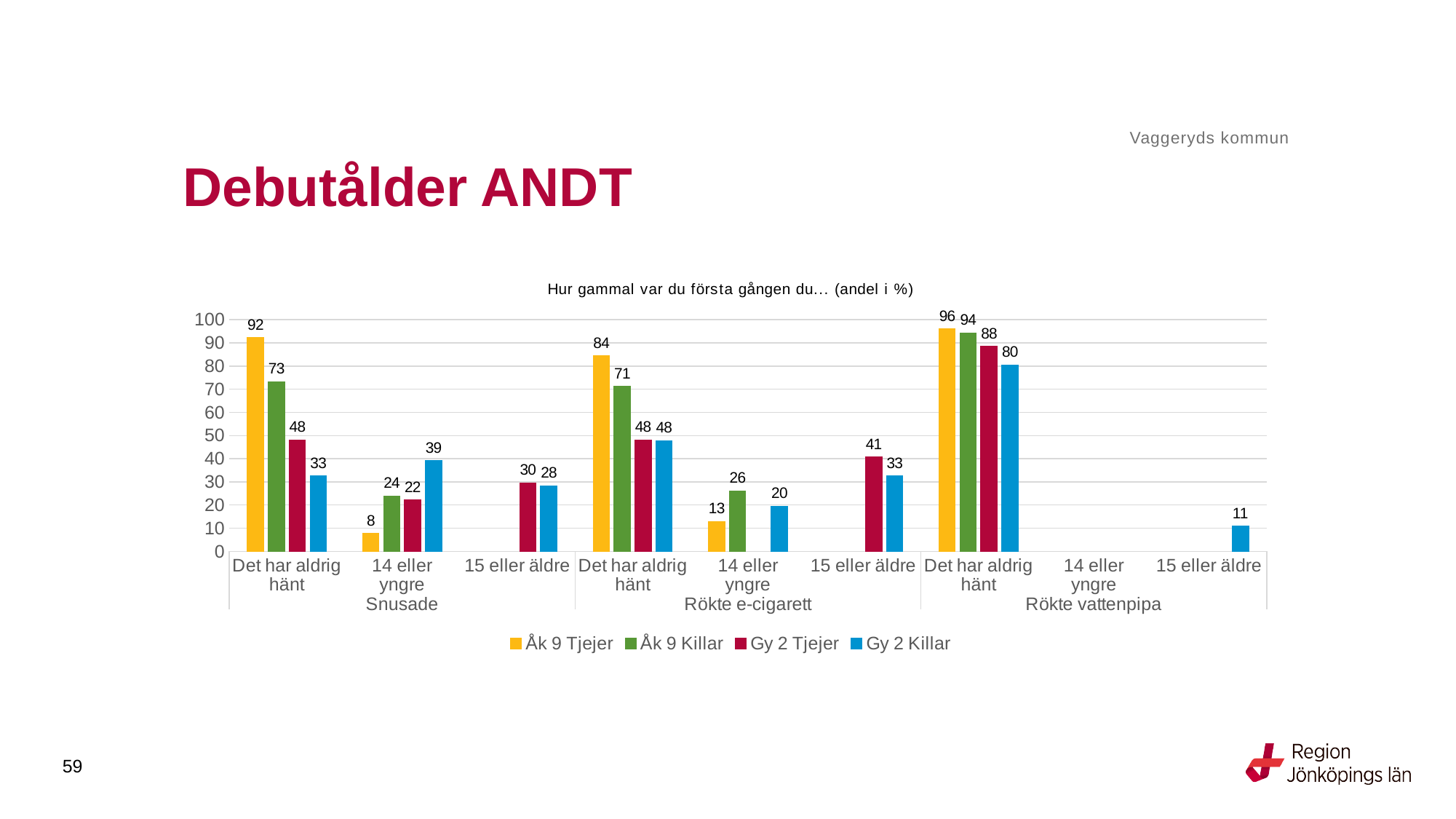
What kind of chart is shown on the slide? Bar chart What is the value for Gy 2 Tjejer for "15 eller äldre" under Rökte e-cigarett? 41 Which colour represents Gy 2 Tjejer in the chart? Red What is the title of the chart? Hur gammal var du första gången du… (andel i %) What is the value for Gy 2 Killar for "15 eller äldre" under Rökte vattenpipa? 11 Which is larger for "14 eller yngre" under Rökte e-cigarett: Åk 9 Killar or Gy 2 Killar? Åk 9 Killar How many series does the legend list? 4 What is the difference between the Åk 9 Tjejer and Åk 9 Killar values for "Det har aldrig hänt" under Snusade? 19 What is the value for Gy 2 Killar for "14 eller yngre" under Snusade? 39 Which series has the lowest value for "14 eller yngre" under Snusade? Åk 9 Tjejer What is the value for Åk 9 Tjejer for "Det har aldrig hänt" under Snusade? 92 Which series has the highest value for "Det har aldrig hänt" under Rökte vattenpipa? Åk 9 Tjejer